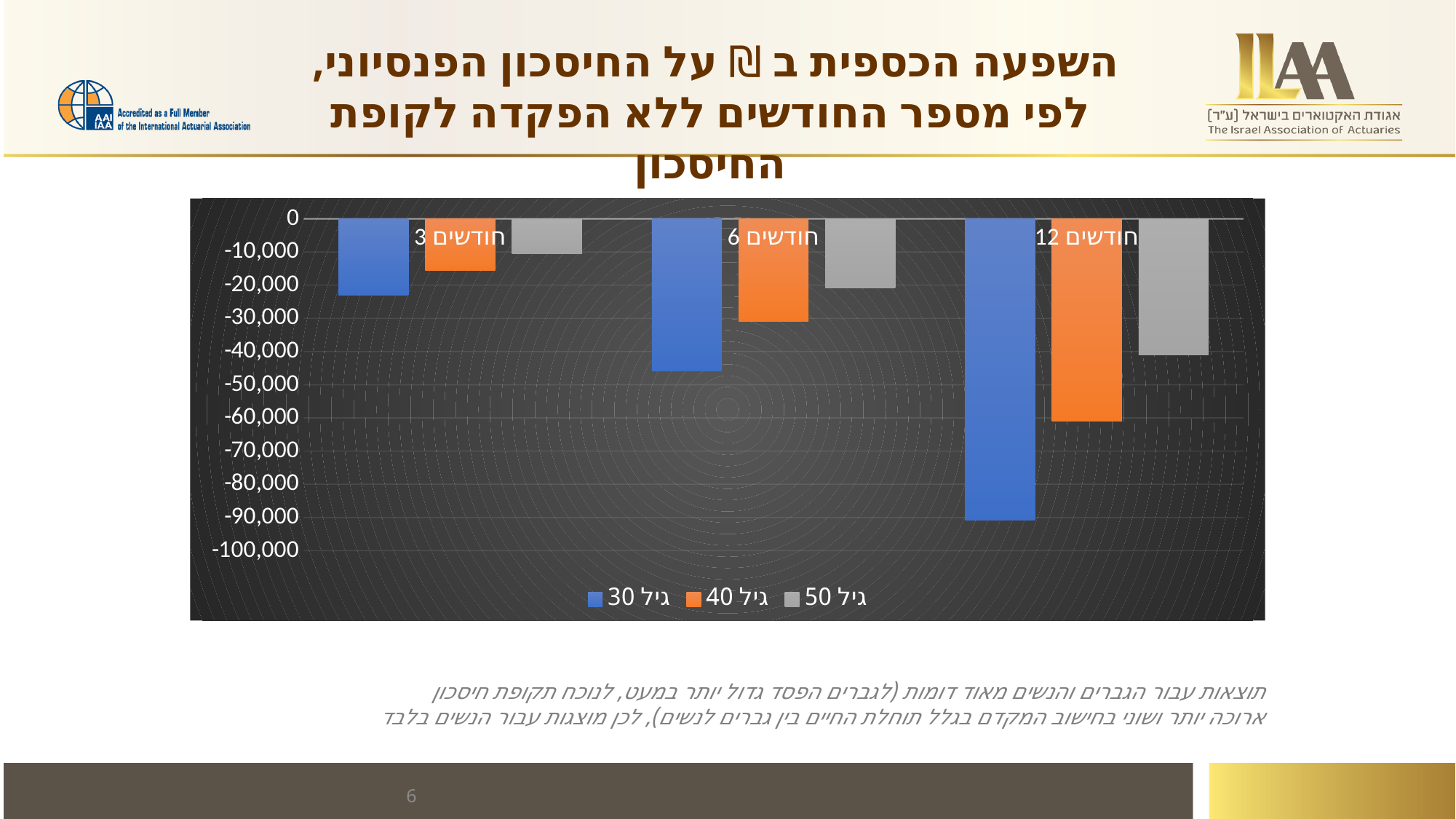
For גיל 30, which category has the lowest (most negative) value? 12 חודשים In the 6 חודשים category, which is more negative: גיל 30 or גיל 50? גיל 30 What are the three legend entries? גיל 30, גיל 40, גיל 50 How many series does the legend list? 3 Is the value for גיל 50 at 3 חודשים greater or less than -20,000? greater In the 12 חודשים category, which series has the lowest (most negative) value? גיל 30 In the 6 חודשים category, which series has the value closest to zero? גיל 50 How many categories are shown on the x axis? 3 Is the value for גיל 30 at 12 חודשים greater or less than -80,000? less What kind of chart is shown on the slide? bar chart As the number of months increases from 3 to 12, do the values for גיל 40 rise or fall? fall Which series is shown in blue? גיל 30